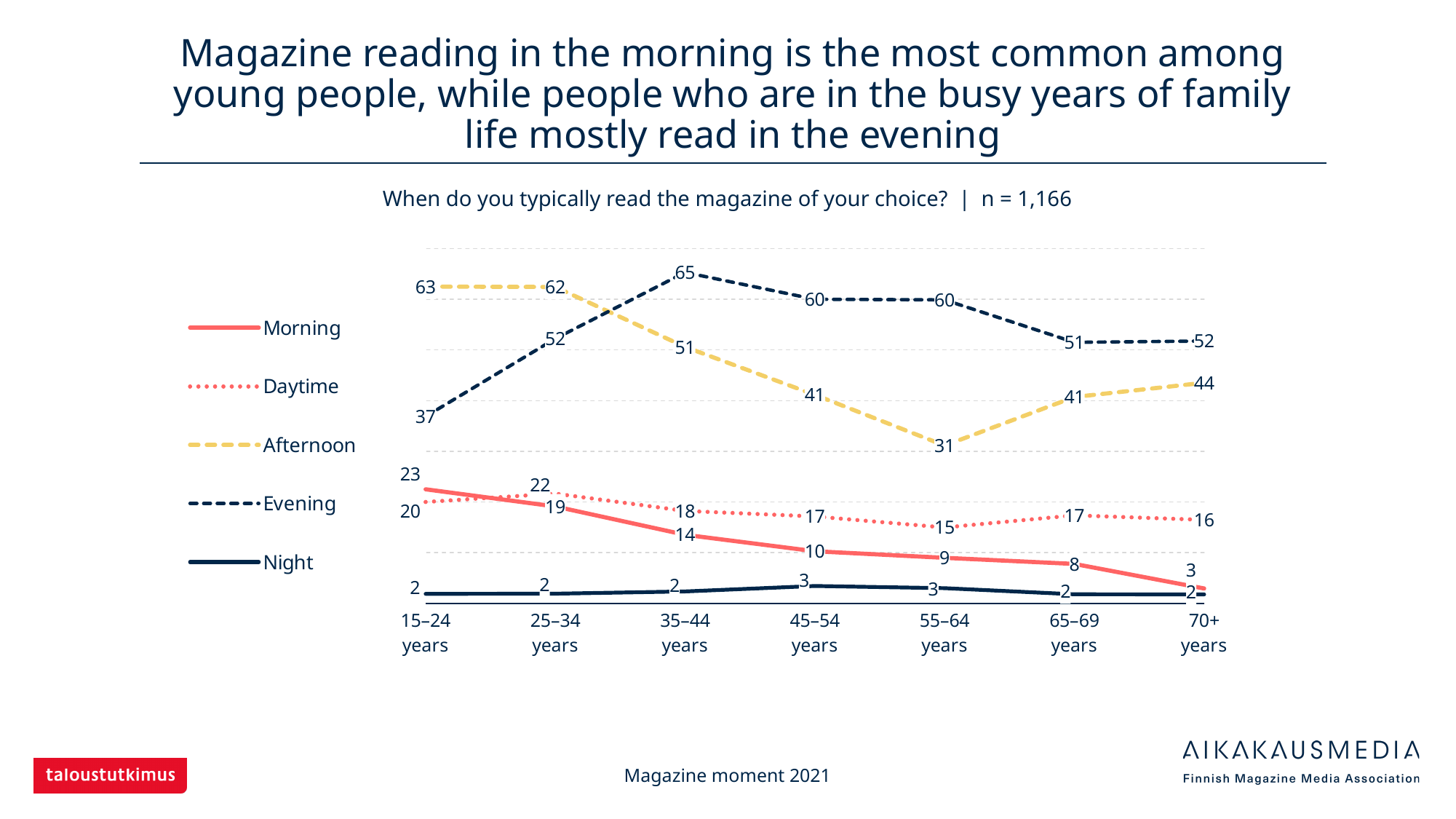
What is the Afternoon value for the 55–64 years group? 31 What is the difference between the Evening and Afternoon values for the 15–24 years group? 26 How many age groups are shown on the x axis? 7 What is the Morning value for the 70+ years group? 3 Does the Morning series rise or fall from the 15–24 years group to the 70+ years group? Fall How many series does the legend list? 5 What is the Daytime value for the 25–34 years group? 22 For the 45–54 years group, which is larger, the Morning value or the Daytime value? Daytime What kind of chart is shown on the slide? Line chart Which age group has the highest Afternoon value? 15–24 years Which age group has the lowest Evening value? 15–24 years What is the Evening value for the 35–44 years group? 65